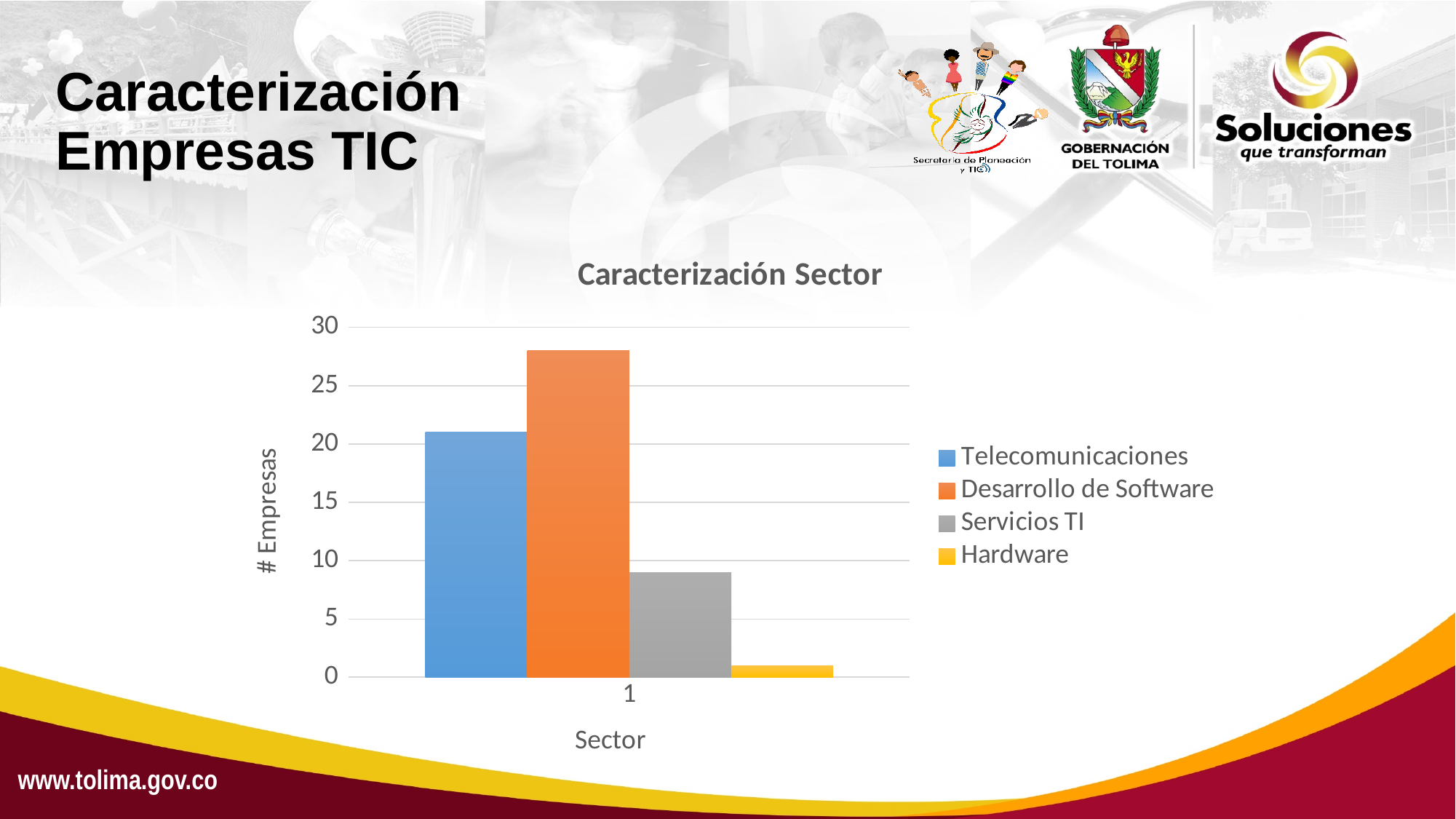
Is the value for Telecomunicaciones greater or less than 15? greater How many series does the legend list? 4 What kind of chart is shown on the slide? bar chart What is the title of the chart? Caracterización Sector Which is larger, the value for Telecomunicaciones or the value for Servicios TI? Telecomunicaciones What is the label of the vertical axis? # Empresas Which series has the highest value? Desarrollo de Software Which is larger, the value for Desarrollo de Software or the value for Telecomunicaciones? Desarrollo de Software Is the value for Servicios TI greater or less than 5? greater Is the value for Desarrollo de Software greater or less than 25? greater Which series has the lowest value? Hardware